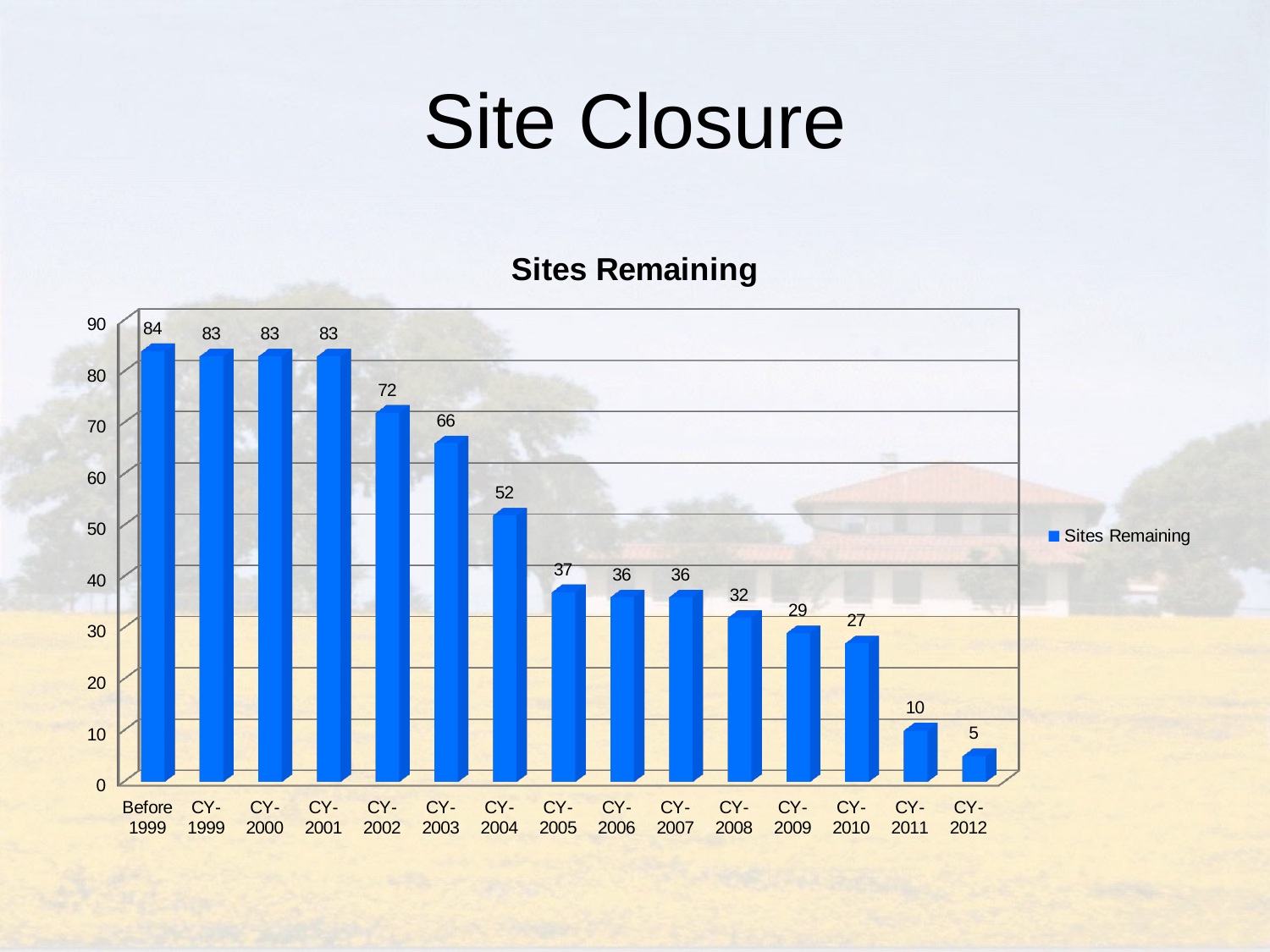
How many series does the legend list? 1 What kind of chart is shown? bar chart What is the difference between the values for CY-2004 and CY-2005? 15 Which is larger, the value for CY-2003 or the value for CY-2009? CY-2003 What is the value for Before 1999? 84 What is the value for CY-2008? 32 Is the value for CY-2011 greater or less than 20? less Which category has the lowest value? CY-2012 Do the values rise or fall from Before 1999 to CY-2012? fall What is the value for CY-2002? 72 Which category has the highest value? Before 1999 How many categories are shown on the x axis? 15